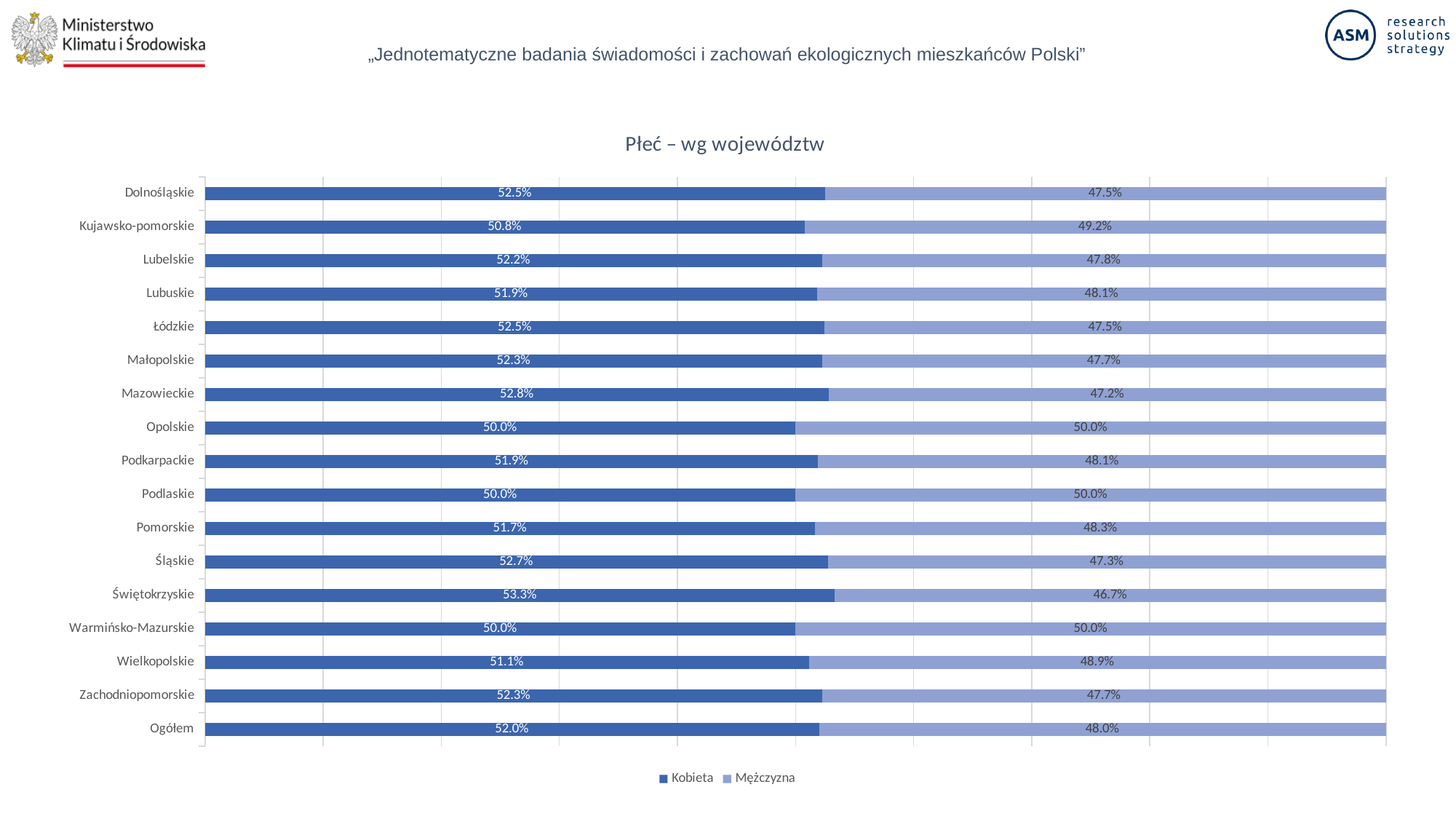
What is the value for Kobieta in the Ogółem row? 52.0% What is the title of the chart? Płeć – wg województw Which region has the highest value for Kobieta? Świętokrzyskie What is the value for Mężczyzna in Wielkopolskie? 48.9% Which has a larger Kobieta value: Mazowieckie or Kujawsko-pomorskie? Mazowieckie What kind of chart is shown on the slide? Stacked horizontal bar chart What is the difference between the Kobieta and Mężczyzna values for Dolnośląskie? 5.0 percentage points What is the value for Kobieta in Mazowieckie? 52.8% What is the value for Mężczyzna in Świętokrzyskie? 46.7% Which region has the lowest value for Mężczyzna? Świętokrzyskie How many series does the legend list? 2 How many categories (rows) are shown on the chart? 17